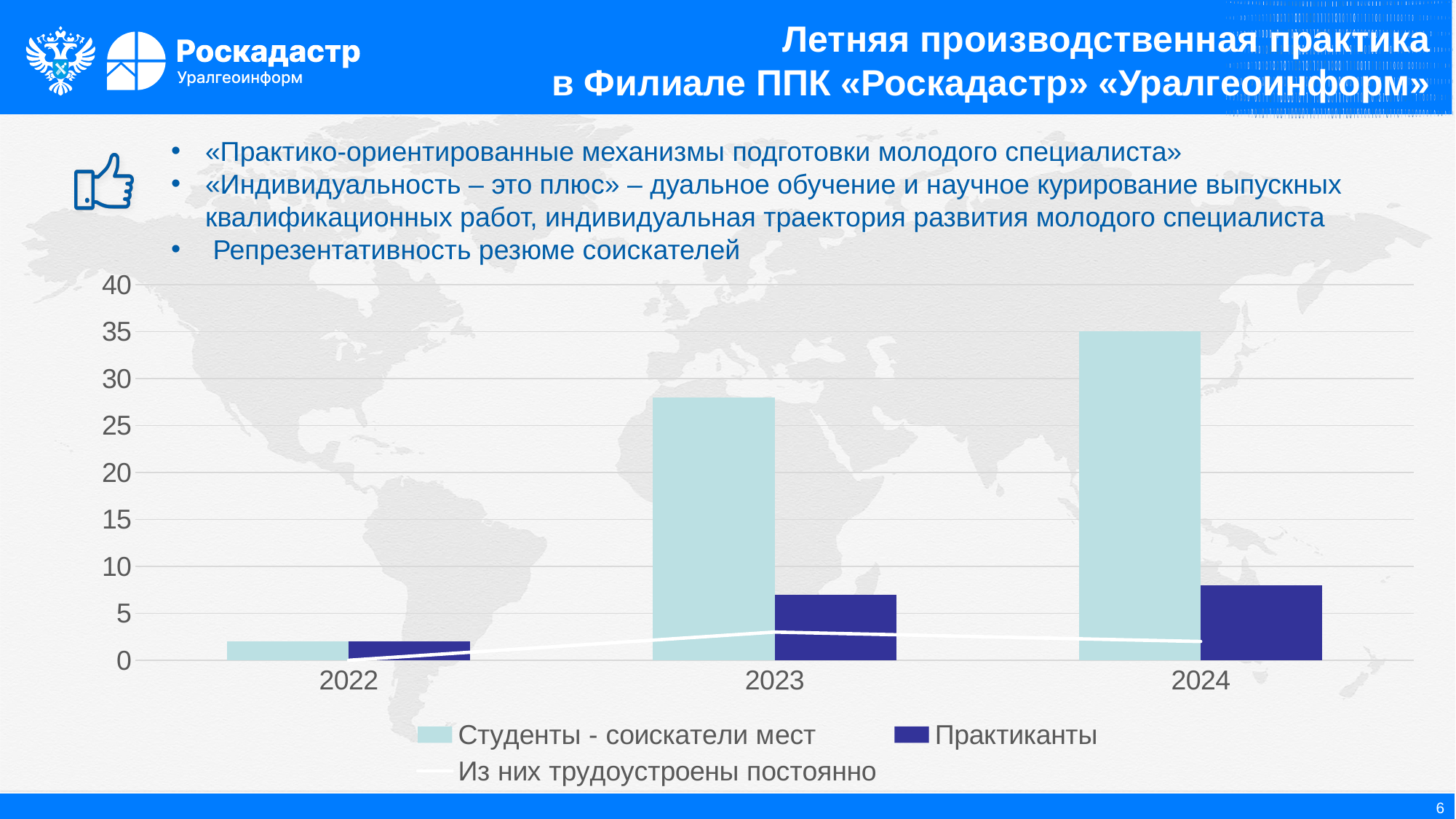
Is the value for «Студенты - соискатели мест» in 2023 greater or less than 25? greater Is the value for «Практиканты» in 2024 greater or less than 10? less In which year is the value for «Студенты - соискатели мест» highest? 2024 Is the value for «Практиканты» in 2023 greater or less than 5? greater What kind of chart is shown on the slide? combination bar and line chart Which is larger in 2023: «Студенты - соискатели мест» or «Практиканты»? Студенты - соискатели мест In which year is the value for «Студенты - соискатели мест» lowest? 2022 Do the values for «Студенты - соискатели мест» rise or fall from 2022 to 2024? rise How many years are shown on the x axis of the chart? 3 What is the value for «Студенты - соискатели мест» in 2024? 35 How many series does the chart legend list? 3 Which series in the legend is drawn as a line rather than bars? Из них трудоустроены постоянно